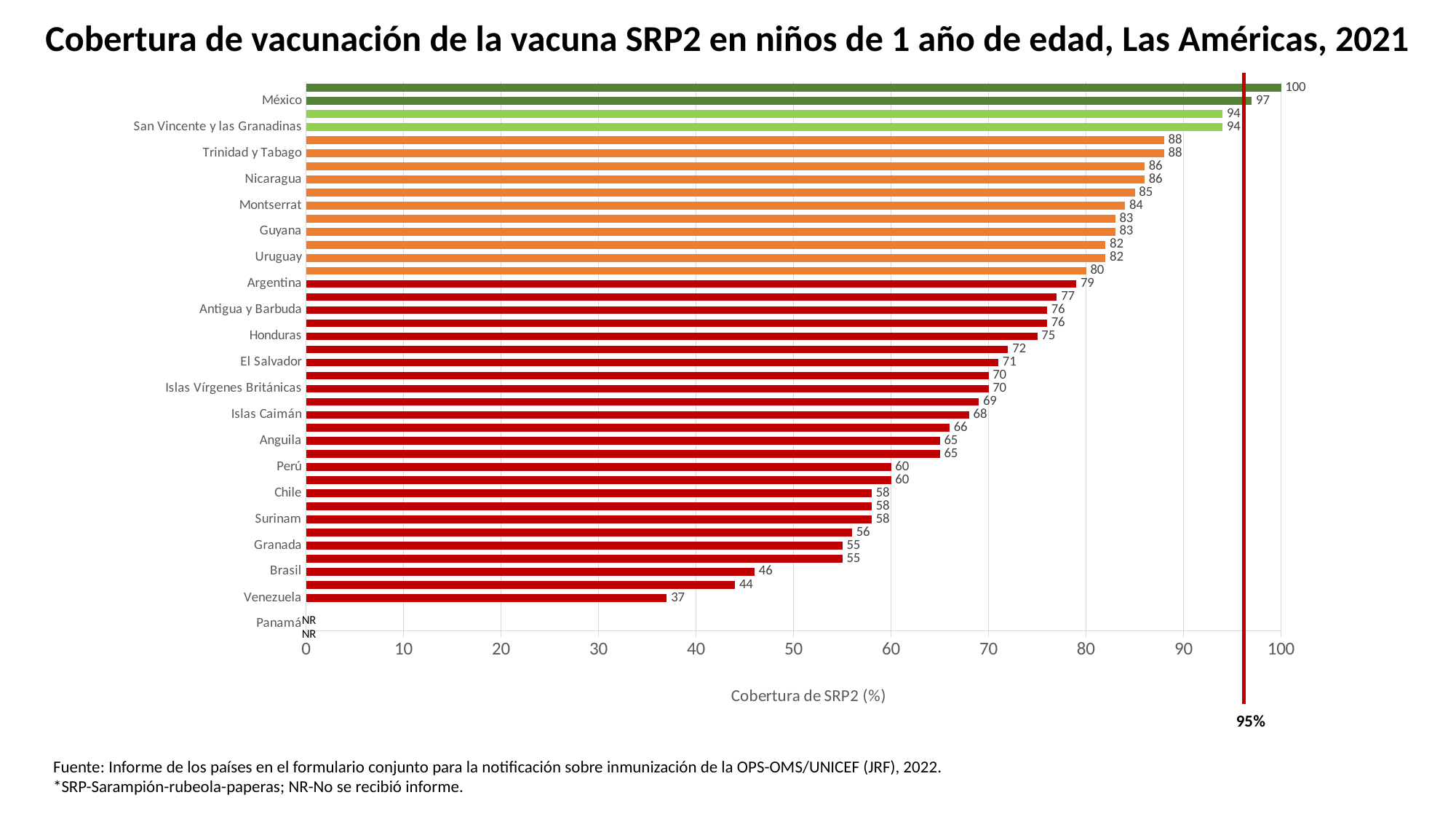
What is the coverage value shown for Argentina? 79 What is shown for Panamá in the chart? NR Which has a higher coverage value, Guyana or Uruguay? Guyana What is the coverage value shown for Venezuela? 37 What is the SRP2 vaccination coverage value for México? 97 Which country has the lowest coverage value plotted in the chart? Venezuela Is the coverage value for Perú greater or less than 50? greater What kind of chart is shown on the slide? Bar chart What is the difference between the coverage values of México and Brasil? 51 What value does the vertical red reference line mark on the chart? 95% What is the title of the horizontal axis? Cobertura de SRP2 (%) What is the coverage value shown for Trinidad y Tabago? 88